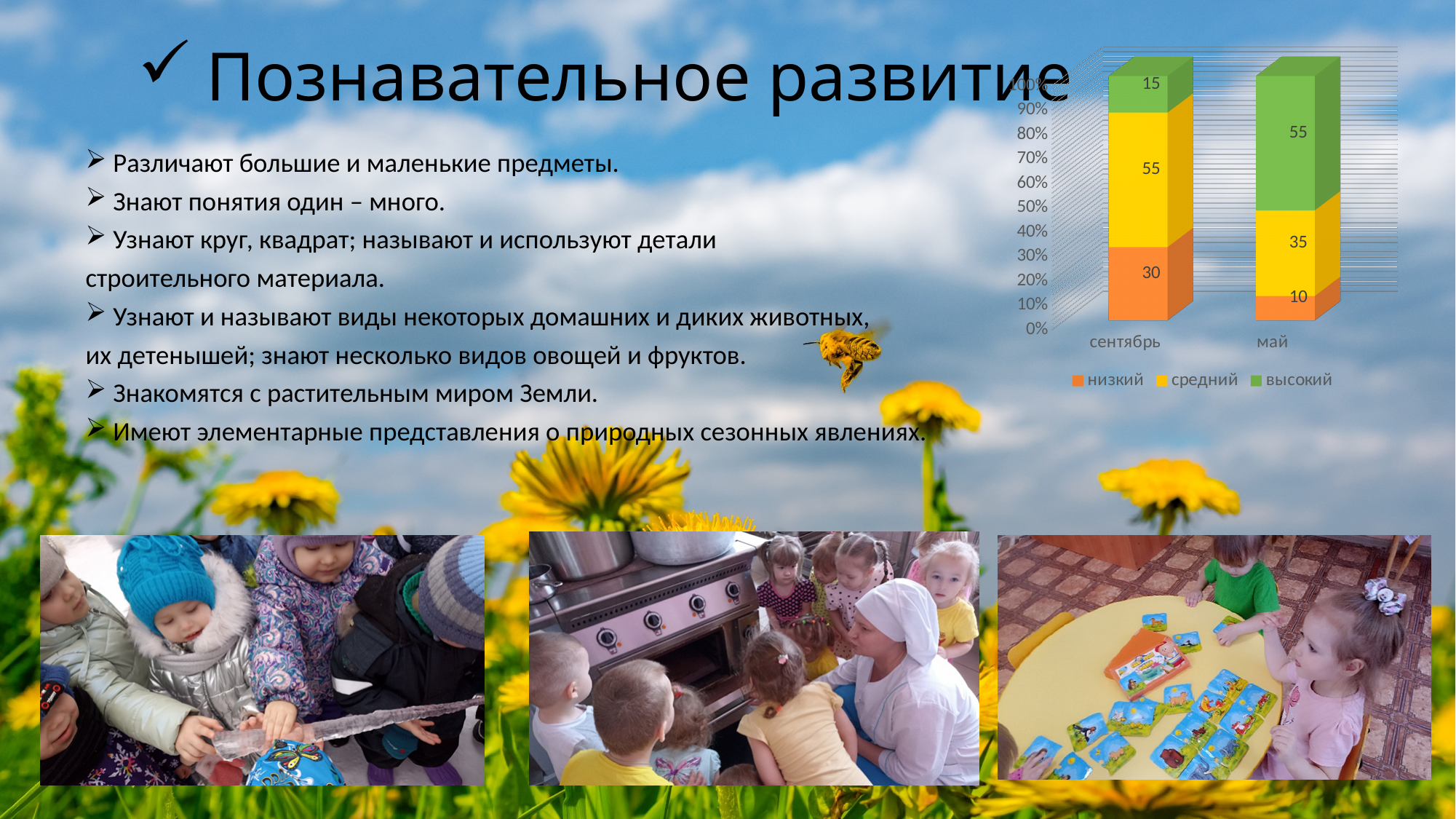
By how much did the высокий value change from сентябрь to май? 40 What is the value of the низкий series for сентябрь? 30 What is the value of the средний series for май? 35 What kind of chart is shown on the slide? stacked bar chart What is the value of the высокий series for сентябрь? 15 How many categories are shown on the x axis of the chart? 2 Does the высокий series rise or fall from сентябрь to май? rise What is the difference between the низкий values for сентябрь and май? 20 Which colour represents the средний series in the chart? yellow Which category has the higher value for the низкий series, сентябрь or май? сентябрь How many series does the chart legend list? 3 What is the value of the высокий series for май? 55